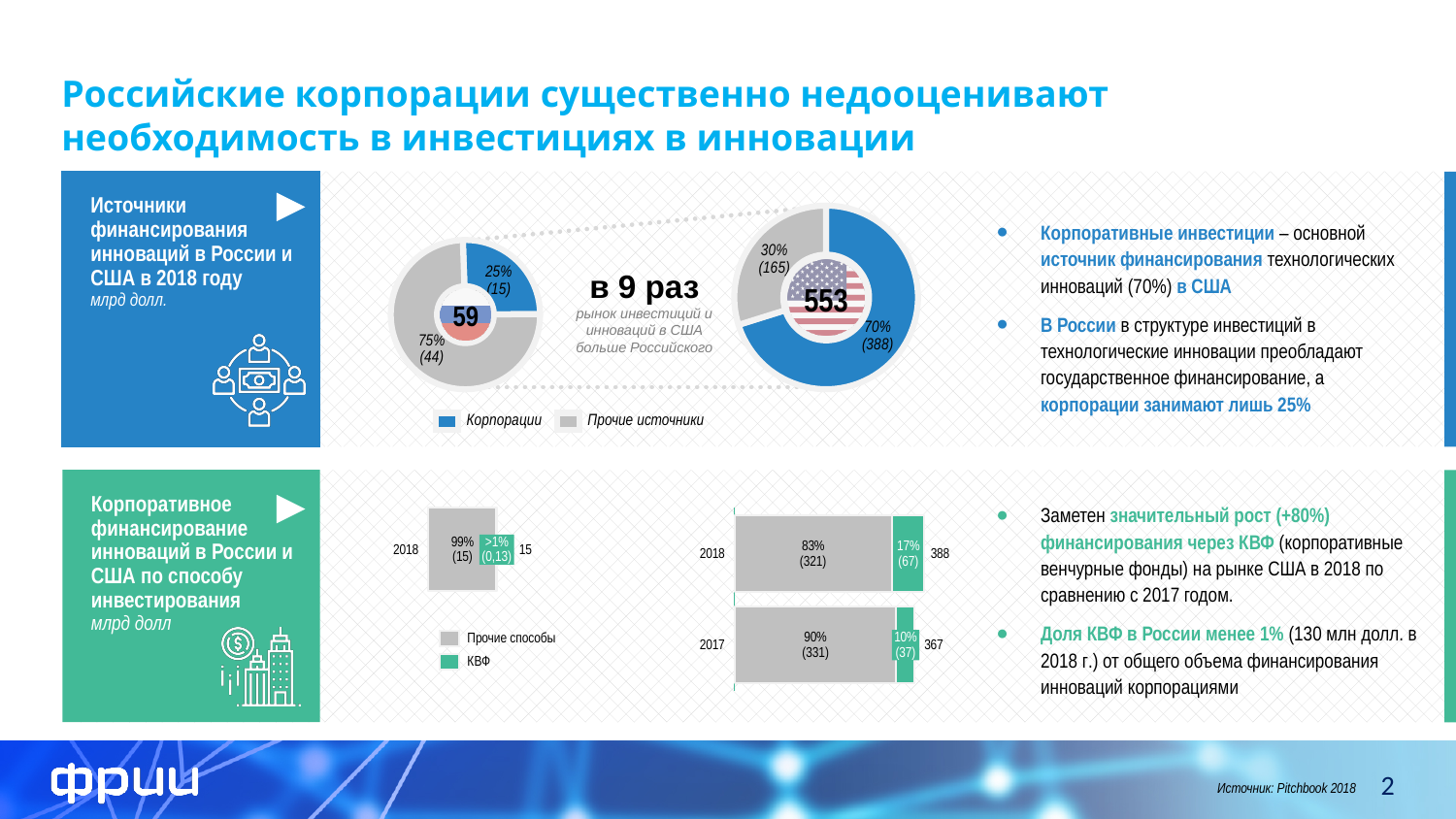
In the bottom chart, which year has the larger 'КВФ' value for the USA, 2017 or 2018? 2018 In the bottom chart, what is the difference between the 'Прочие способы' values for the USA in 2017 and 2018? 10 In the top chart 'Источники финансирования инноваций в России и США в 2018 году', what is the total value shown in the centre of the Russia donut? 59 In the top chart, what share of innovation financing in Russia comes from 'Корпорации'? 25% In the bottom chart 'Корпоративное финансирование инноваций в России и США по способу инвестирования', what is the value for 'КВФ' in the USA in 2018? 67 In the top chart, how many series does the legend list? 2 In the top chart, what share of innovation financing in the USA comes from 'Корпорации'? 70% In the top chart, what type of chart is used to show the sources of financing? Pie (donut) chart In the bottom chart, what is the total of the USA stacked bar for 2017? 367 In the bottom chart, what percentage share does 'КВФ' have in Russia in 2018? >1% In the top chart, what is the value (in brackets) for 'Прочие источники' in the USA donut? 165 In the top chart 'Источники финансирования инноваций в России и США в 2018 году', what is the total value shown in the centre of the USA donut? 553